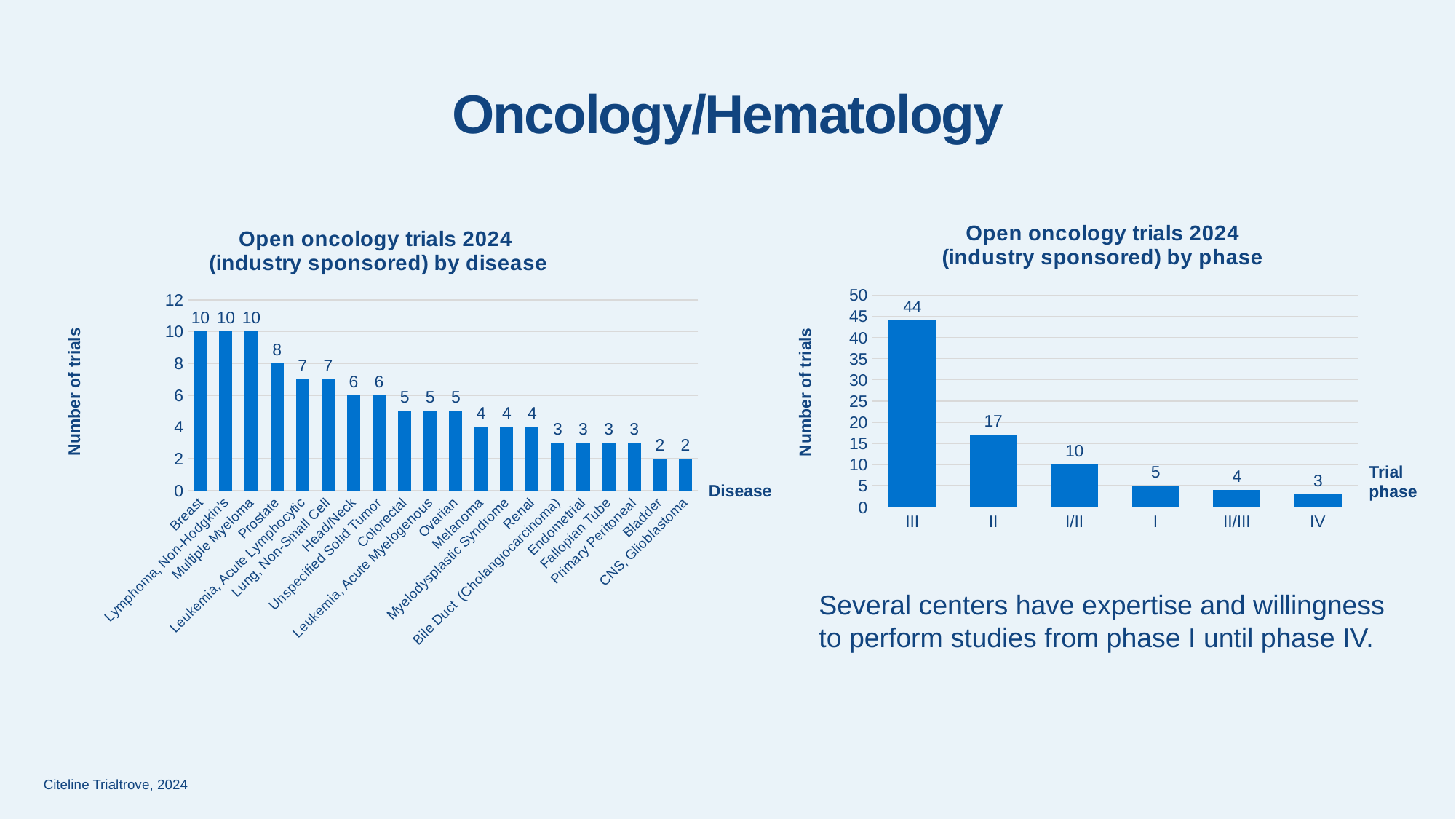
What type of chart is the 'Open oncology trials 2024 (industry sponsored) by disease' chart? Bar chart In the 'Open oncology trials 2024 (industry sponsored) by phase' chart, which trial phase has the lowest number of trials? IV In the 'Open oncology trials 2024 (industry sponsored) by disease' chart, how many disease categories are shown? 20 In the 'Open oncology trials 2024 (industry sponsored) by disease' chart, how many trials are there for Prostate? 8 In the 'Open oncology trials 2024 (industry sponsored) by phase' chart, how many trials are in phase III? 44 In the 'Open oncology trials 2024 (industry sponsored) by phase' chart, how many trial phases are shown on the x axis? 6 In the 'Open oncology trials 2024 (industry sponsored) by disease' chart, which has more trials, Head/Neck or Bladder? Head/Neck In the 'Open oncology trials 2024 (industry sponsored) by disease' chart, how many trials are there for Melanoma? 4 In the 'Open oncology trials 2024 (industry sponsored) by phase' chart, which trial phase has the highest number of trials? III In the 'Open oncology trials 2024 (industry sponsored) by phase' chart, is the value for phase II greater or less than 20? less In the 'Open oncology trials 2024 (industry sponsored) by disease' chart, what is the difference between the number of trials for Breast and for Colorectal? 5 In the 'Open oncology trials 2024 (industry sponsored) by phase' chart, what is the difference between the number of phase III trials and phase II trials? 27